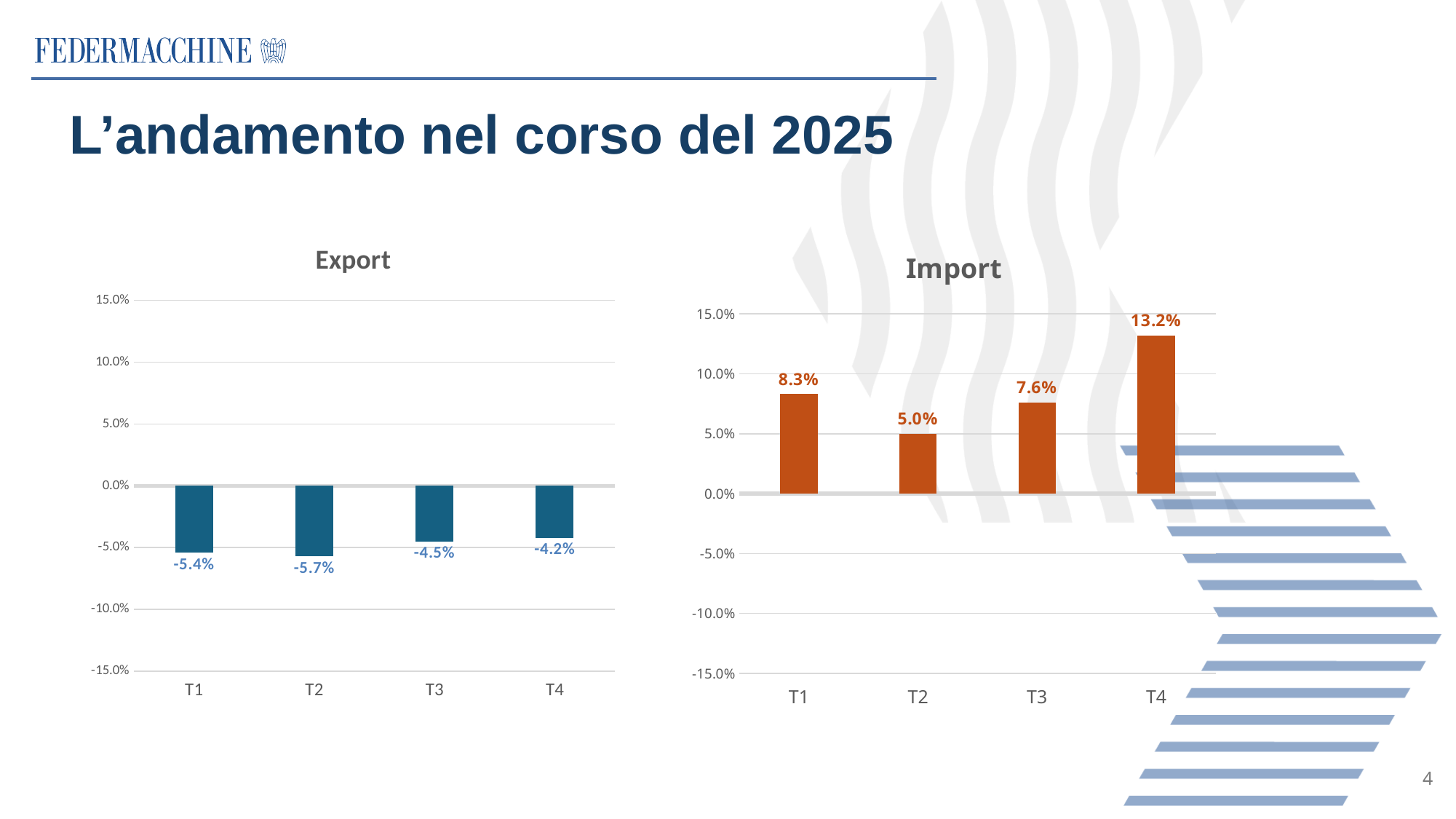
In the Export chart, what is the difference between the T4 value and the T1 value? 1.2% In the Import chart, what is the value for T3? 7.6% What kind of chart is the Import chart? bar chart In the Export chart, is the value for T3 greater or less than -5.0%? greater What is the title of the chart on the left side of the slide? Export In the Export chart, which quarter has the lowest value? T2 In the Import chart, what is the difference between the T4 value and the T2 value? 8.2% How many quarters are shown in the Export chart? 4 In the Export chart, what is the value for T2? -5.7% In the Import chart, which quarter has the lowest value? T2 In the Import chart, which quarter has the highest value? T4 In the Import chart, which is larger, the value for T1 or the value for T3? T1